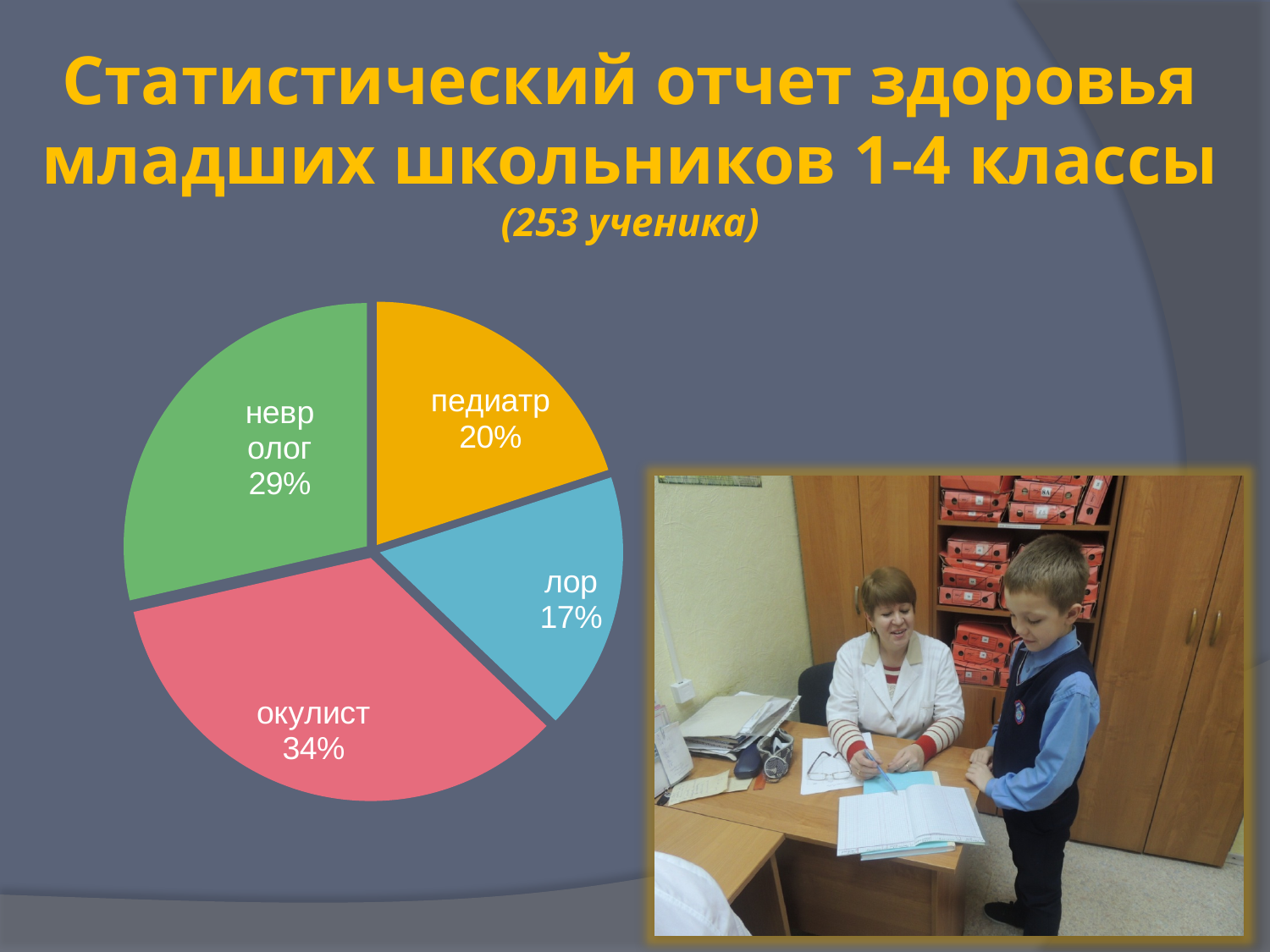
What is the difference in percentage points between the окулист slice and the лор slice? 17 Which is larger, the невролог slice or the педиатр slice? невролог What is the difference in percentage points between the невролог slice and the педиатр slice? 9 What colour is the окулист slice of the pie? pink/red Which slice of the pie is the largest? окулист What percentage of the pie is labelled окулист? 34% What percentage of the pie is labelled невролог? 29% What kind of chart is shown on the slide? pie chart What percentage of the pie is labelled педиатр? 20% What percentage of the pie is labelled лор? 17% How many slices does the pie chart have? 4 Which slice of the pie is the smallest? лор